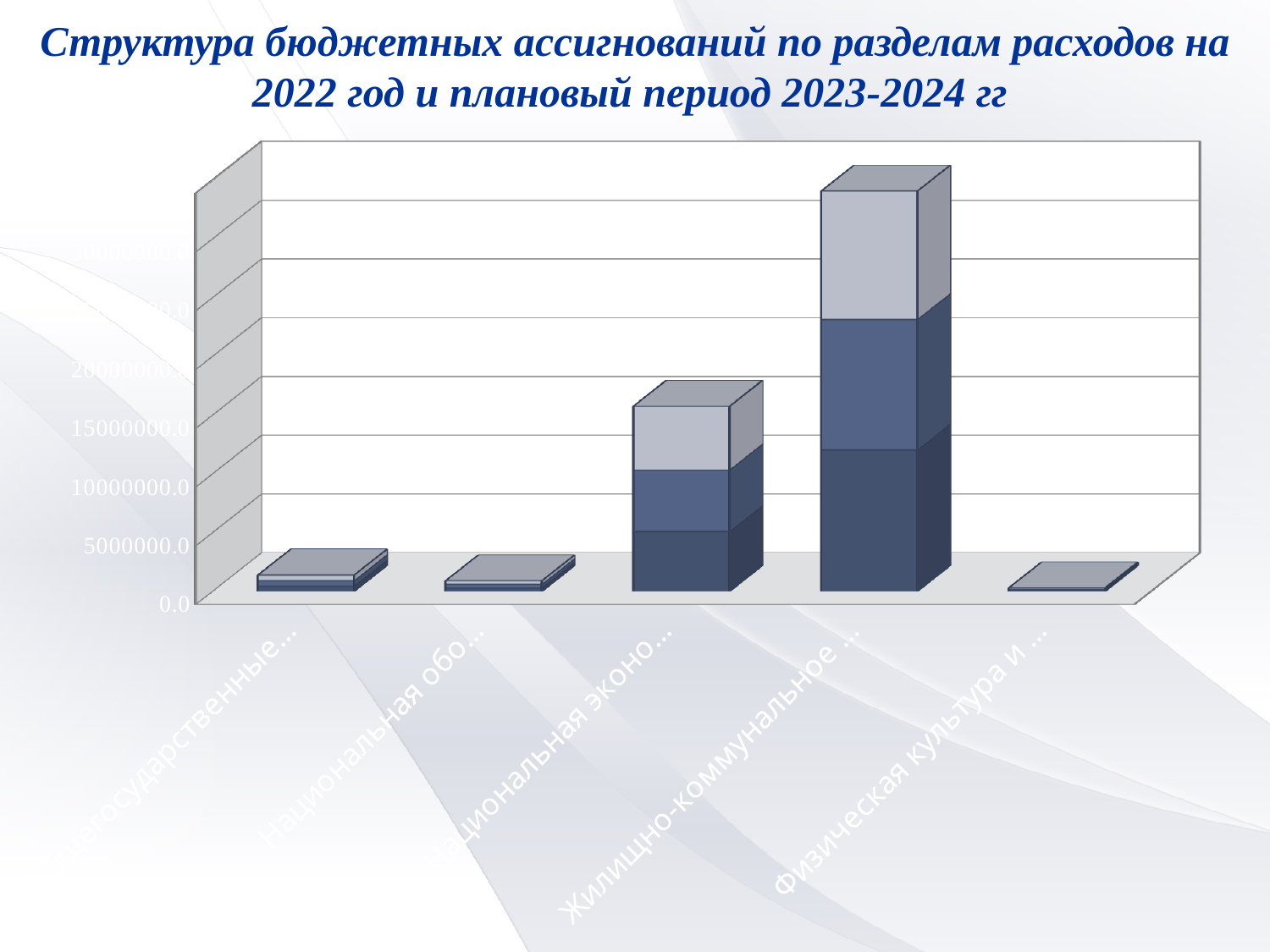
Is the total for the 'Жилищно-коммунальное ...' bar greater or less than 20000000.0? greater Is the total for the 'Общегосударственные...' bar greater or less than 5000000.0? less Which bar is taller: 'Национальная эконо...' or 'Национальная обо...'? Национальная эконо... How many stacked segments make up each bar? 3 Which category has the tallest stacked bar? Жилищно-коммунальное ... Is the total for the 'Физическая культура и ...' bar greater or less than 5000000.0? less What is the title of the slide containing the chart? Структура бюджетных ассигнований по разделам расходов на 2022 год и плановый период 2023-2024 гг What kind of chart is shown on the slide? Stacked bar chart Which bar is taller: 'Жилищно-коммунальное ...' or 'Национальная эконо...'? Жилищно-коммунальное ... How many expenditure categories are plotted along the x axis? 5